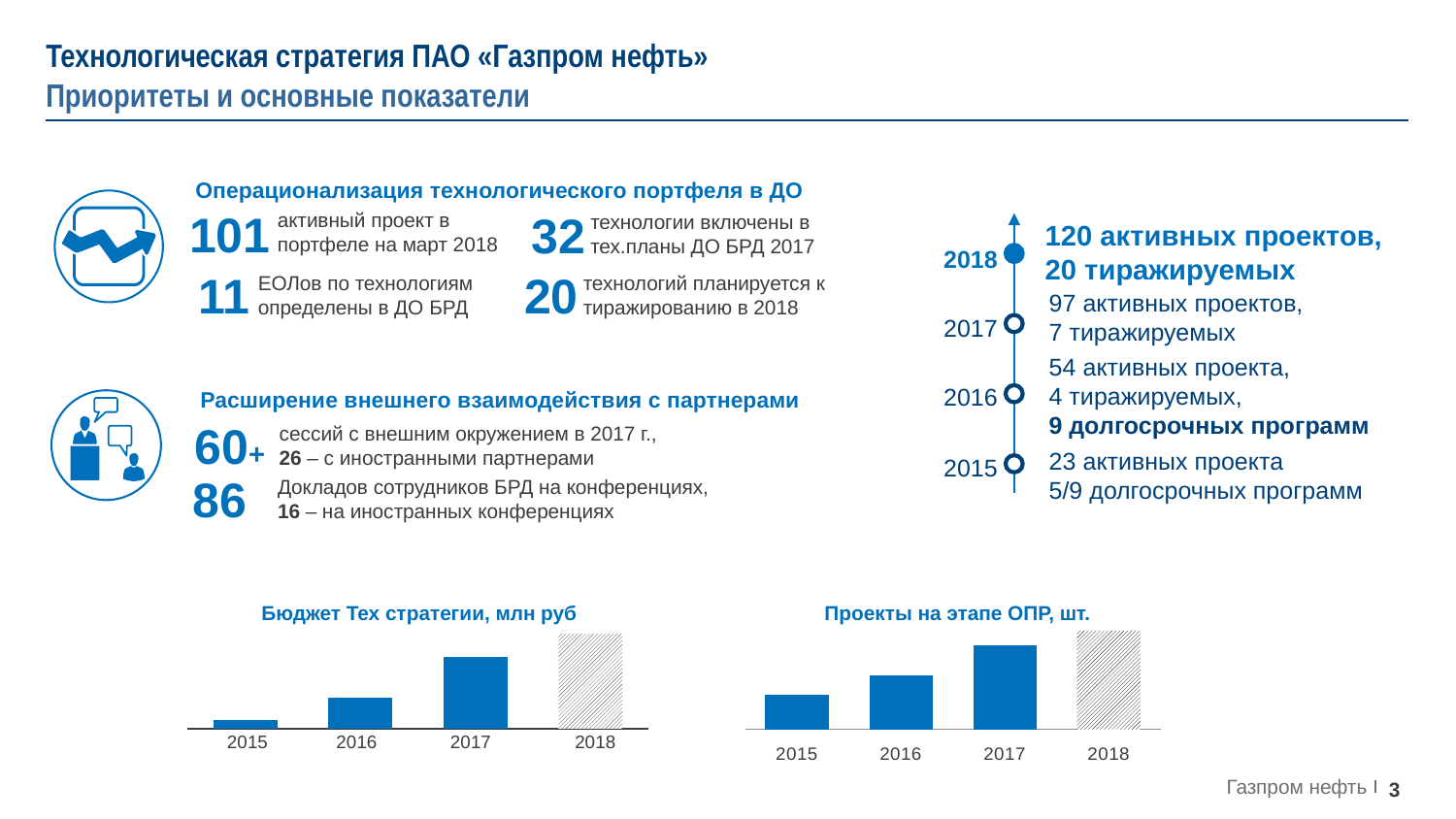
In the chart titled "Бюджет Тех стратегии, млн руб", which is larger, the bar for 2016 or the bar for 2017? 2017 What kind of chart is the chart titled "Проекты на этапе ОПР, шт."? bar chart What is the title of the bar chart on the bottom right of the slide? Проекты на этапе ОПР, шт. In the chart titled "Проекты на этапе ОПР, шт.", do the values rise or fall from 2015 to 2018? rise How many categories are shown on the x axis of the chart titled "Проекты на этапе ОПР, шт."? 4 In the chart titled "Бюджет Тех стратегии, млн руб", which year has the highest bar? 2018 In the chart titled "Проекты на этапе ОПР, шт.", which year has the highest bar? 2018 In the chart titled "Бюджет Тех стратегии, млн руб", do the values rise or fall from 2015 to 2018? rise In the chart titled "Бюджет Тех стратегии, млн руб", which year has the lowest bar? 2015 How many categories are shown on the x axis of the chart titled "Бюджет Тех стратегии, млн руб"? 4 What kind of chart is the chart titled "Бюджет Тех стратегии, млн руб"? bar chart In the chart titled "Проекты на этапе ОПР, шт.", which year has the lowest bar? 2015